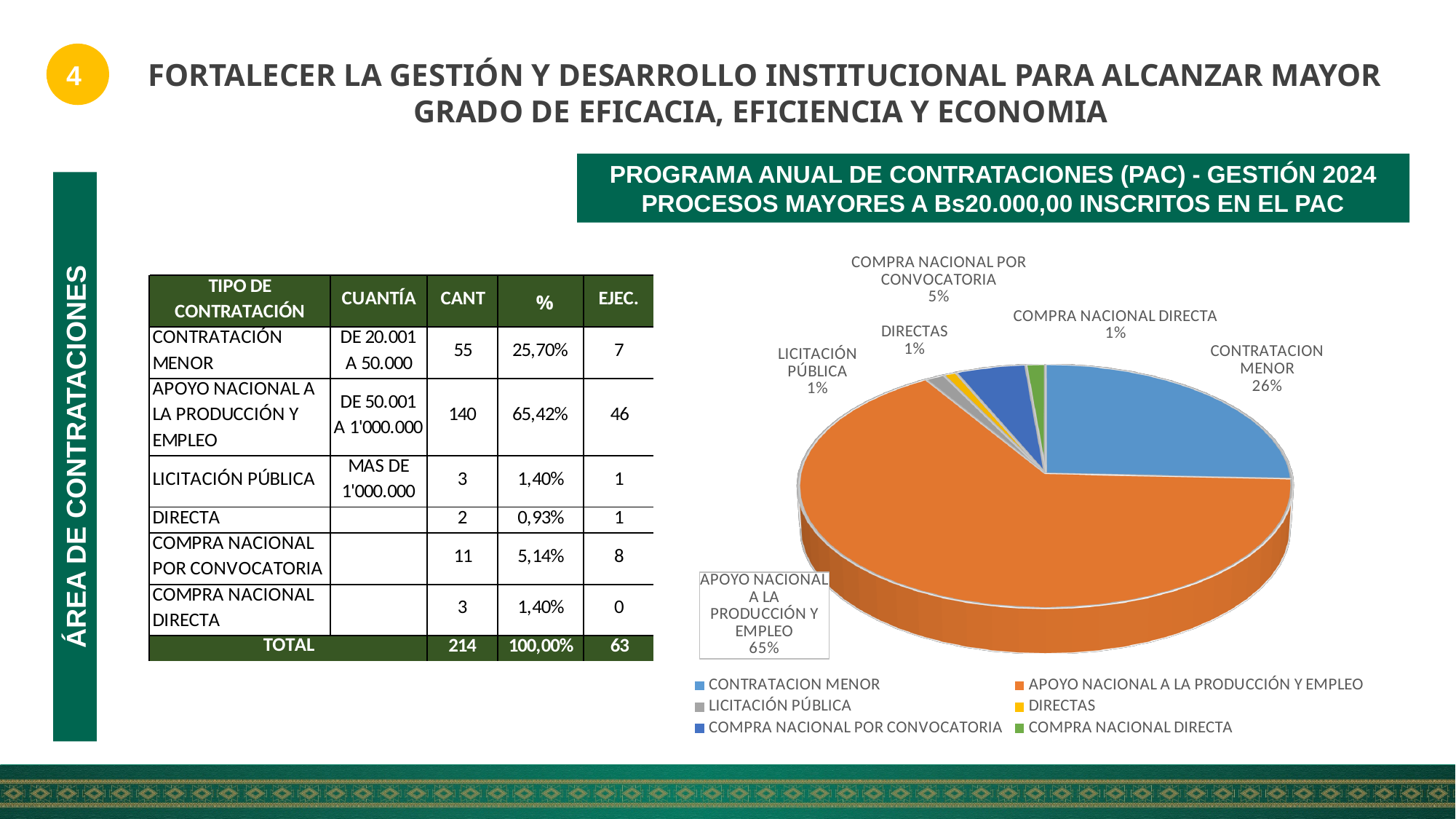
What percentage does the pie chart show for LICITACIÓN PÚBLICA? 1% What colour is the slice for APOYO NACIONAL A LA PRODUCCIÓN Y EMPLEO in the pie chart? Orange What is the difference in percentage points between APOYO NACIONAL A LA PRODUCCIÓN Y EMPLEO and CONTRATACION MENOR in the pie chart? 39 percentage points Which category has the largest slice in the pie chart? APOYO NACIONAL A LA PRODUCCIÓN Y EMPLEO What share of the pie does DIRECTAS represent? 1% What percentage does the pie chart show for CONTRATACION MENOR? 26% What percentage does the pie chart show for APOYO NACIONAL A LA PRODUCCIÓN Y EMPLEO? 65% How many slices does the pie chart have? 6 What type of chart is shown on the slide? Pie chart Which slice is larger in the pie chart: CONTRATACION MENOR or COMPRA NACIONAL POR CONVOCATORIA? CONTRATACION MENOR How many entries does the pie chart's legend list? 6 What percentage does the pie chart show for COMPRA NACIONAL POR CONVOCATORIA? 5%